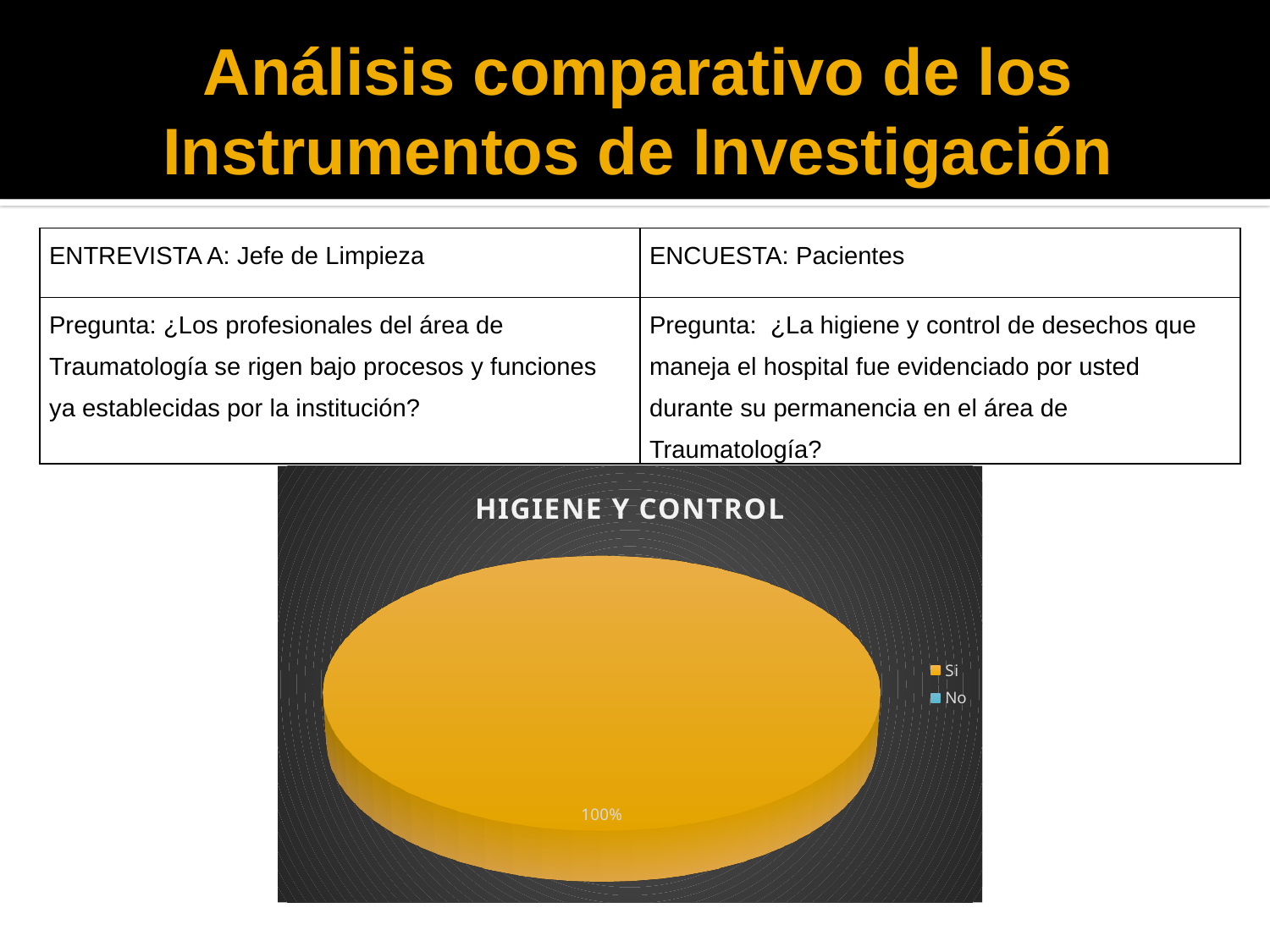
How many entries does the chart legend list? 2 What is the title of the chart? HIGIENE Y CONTROL What kind of chart is shown on the slide? pie chart Which is larger in the pie chart, the "Si" slice or the "No" slice? Si What share of the pie does the "Si" slice take? 100% What colour is the "Si" slice in the pie chart? orange What value is printed as the data label on the pie chart? 100% Which category has the smallest slice in the pie chart? No Is the share for "Si" greater or less than 50%? greater Which category has the largest slice in the pie chart? Si